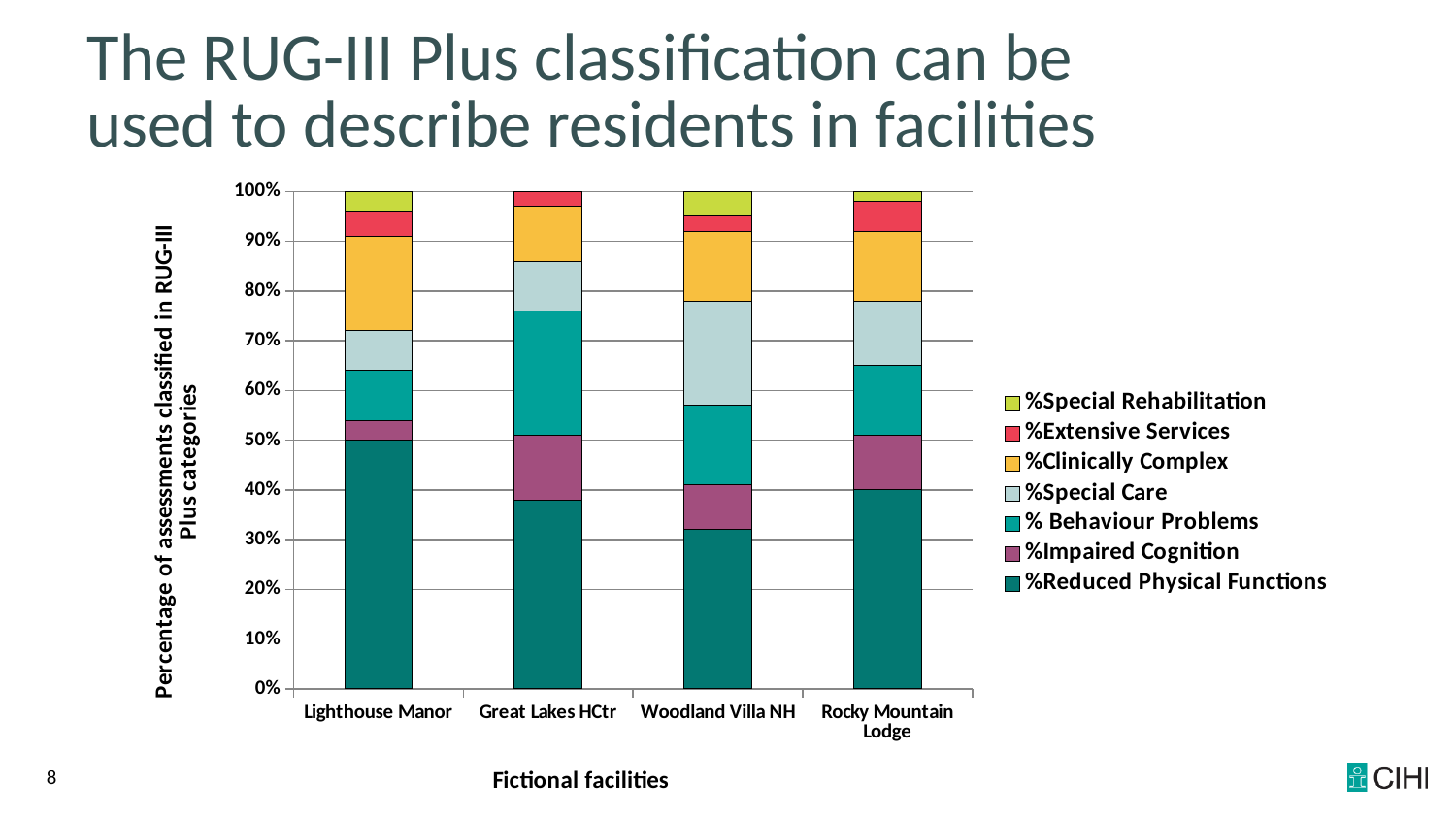
Which facility has the highest share of %Reduced Physical Functions? Lighthouse Manor Which is larger, the %Impaired Cognition segment for Great Lakes HCtr or for Lighthouse Manor? Great Lakes HCtr Is the %Reduced Physical Functions value for Woodland Villa NH greater or less than 30%? greater How many facilities are shown along the x axis? 4 How many series does the legend list? 7 What is the total of the stacked bar for Lighthouse Manor? 100% What kind of chart is shown on the slide? Stacked bar chart Which facility has the lowest share of %Reduced Physical Functions? Woodland Villa NH Is the %Reduced Physical Functions value for Great Lakes HCtr greater or less than 40%? less Which facility has the largest % Behaviour Problems segment? Great Lakes HCtr What is the title of the x axis? Fictional facilities Which facility has the largest %Special Care segment? Woodland Villa NH